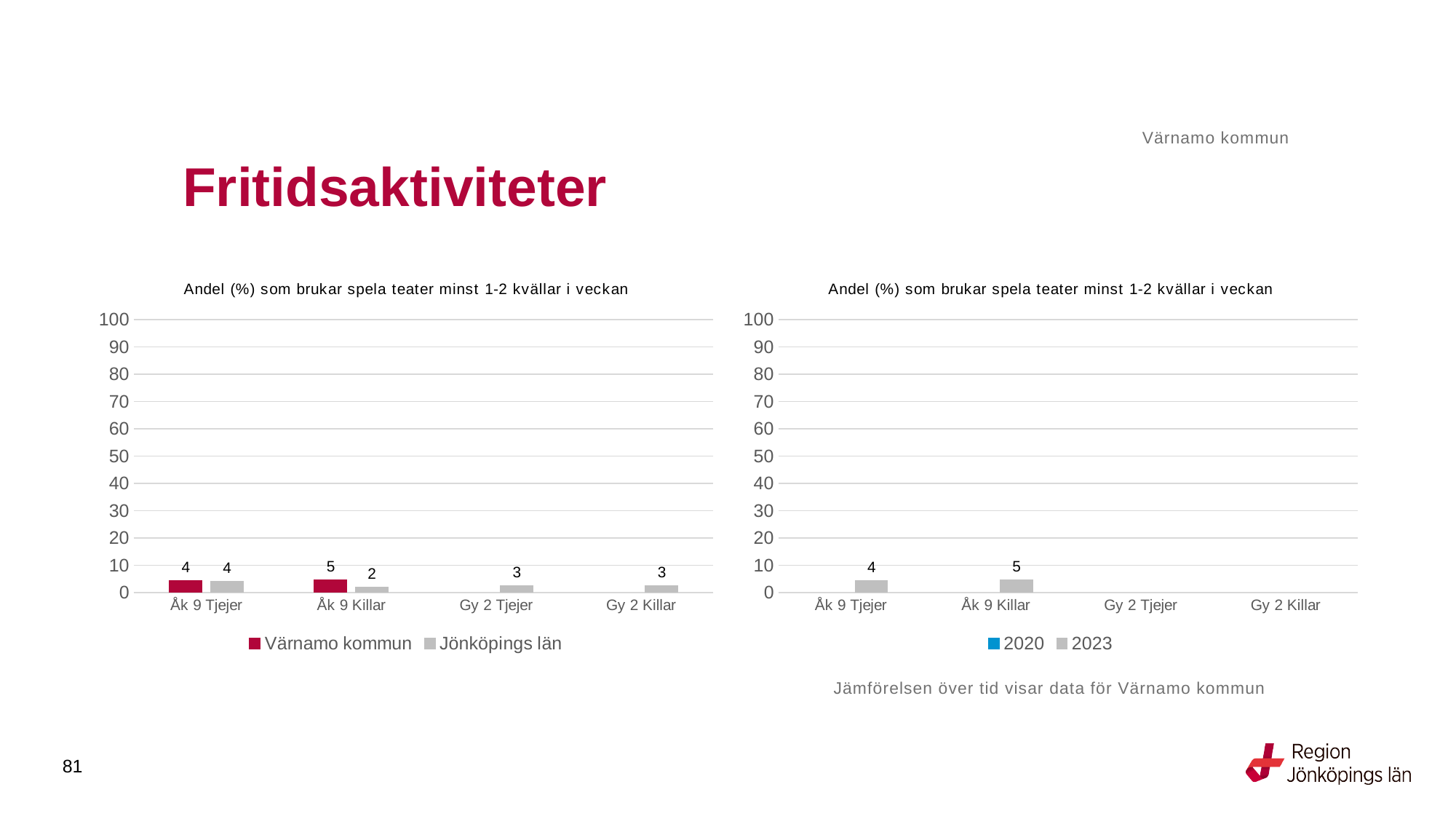
In the right chart, which category has the highest value for 2023? Åk 9 Killar In the left chart, what is the difference between Värnamo kommun and Jönköpings län for Åk 9 Killar? 3 How many series does the legend of the left chart list? 2 In the right chart, what is the value for 2023 for Åk 9 Tjejer? 4 In the left chart, which category has the lowest value for Jönköpings län? Åk 9 Killar In the left chart, which is larger for Åk 9 Killar: Värnamo kommun or Jönköpings län? Värnamo kommun In the left chart, what is the value for Värnamo kommun for Åk 9 Killar? 5 What kind of chart is the right chart? Bar chart In the right chart, what is the value for 2023 for Åk 9 Killar? 5 In the left chart, what is the value for Jönköpings län for Gy 2 Tjejer? 3 In the left chart, what is the value for Jönköpings län for Åk 9 Killar? 2 How many categories are shown on the x axis of the right chart? 4